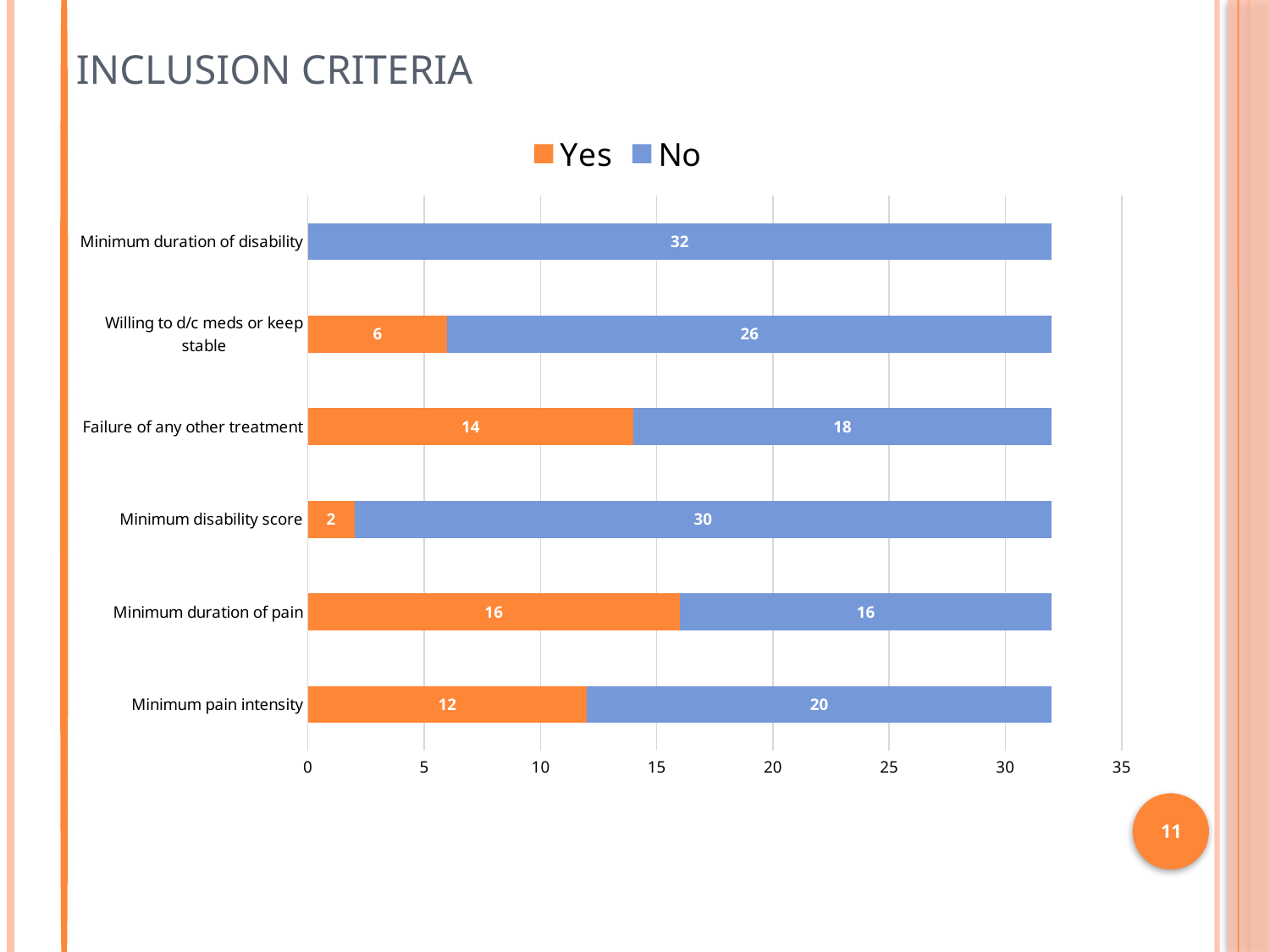
Which category has the lowest "No" value? Minimum duration of pain What is the "Yes" value for Minimum pain intensity? 12 What is the difference between the "No" and "Yes" values for Willing to d/c meds or keep stable? 20 How many series does the legend list? 2 What colour represents the "Yes" series? Orange Which category has the highest "Yes" value? Minimum duration of pain How many categories are shown on the chart? 6 What is the total of the stacked bar for Failure of any other treatment? 32 What is the "No" value for Minimum disability score? 30 What kind of chart is shown on the slide? Stacked bar chart What is the "Yes" value for Failure of any other treatment? 14 Which is larger for Minimum pain intensity, the "Yes" value or the "No" value? No